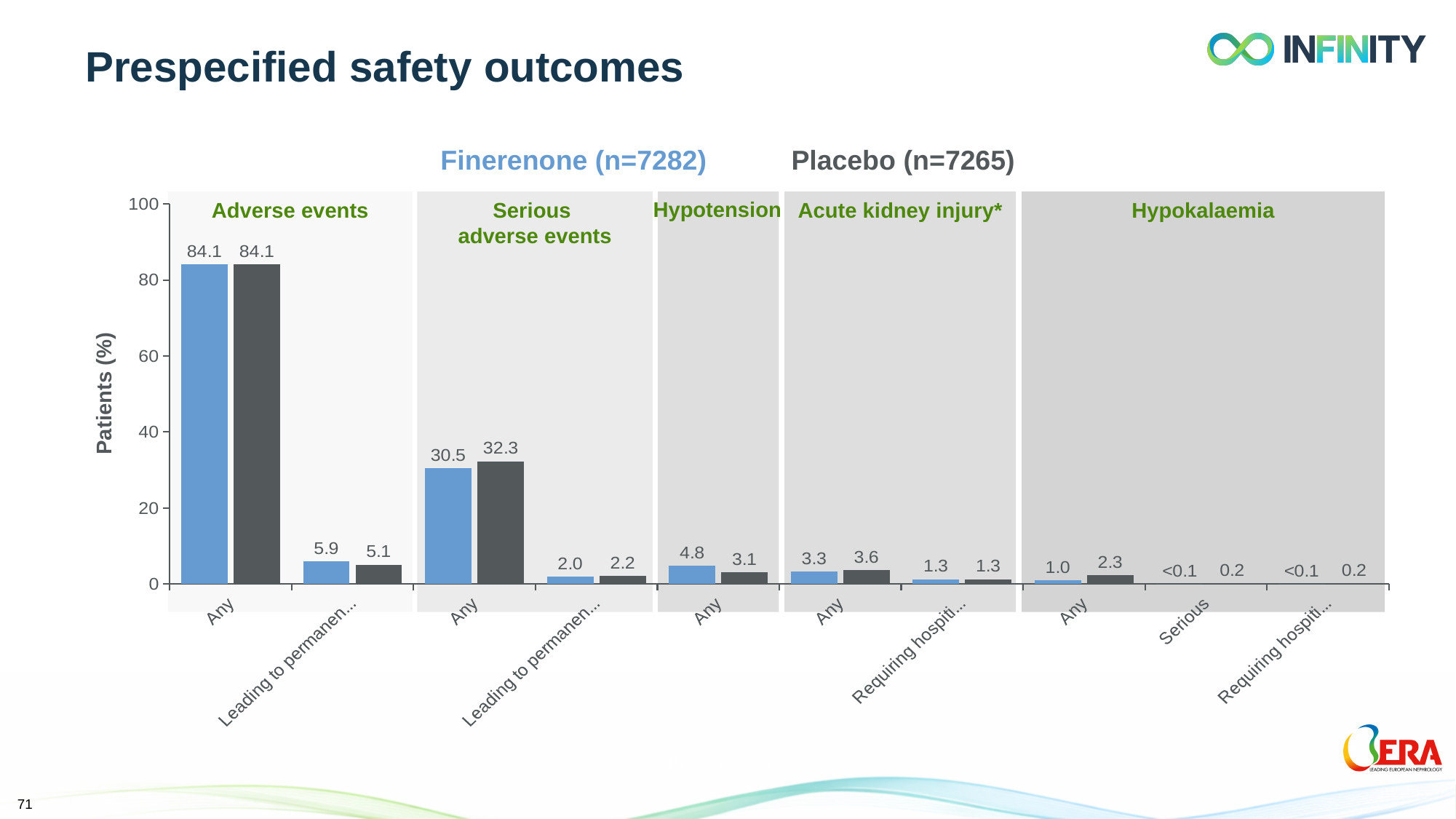
What type of chart is shown on the slide? bar chart How many series does the chart show (as named above the chart)? 2 What is the Placebo value for 'Any' in the Hypokalaemia panel? 2.3 What is the Finerenone value for 'Serious' in the Hypokalaemia panel? <0.1 Which is larger for 'Any' in the Hypotension panel, Finerenone or Placebo? Finerenone What is the Placebo value for 'Any' in the Serious adverse events panel? 32.3 What is the label of the y axis? Patients (%) Is the Finerenone value for 'Any' in the Adverse events panel greater or less than 80? greater What is the difference between the Placebo and Finerenone values for 'Any' in the Serious adverse events panel? 1.8 Which is larger for 'Any' in the Hypokalaemia panel, Finerenone or Placebo? Placebo What is the Finerenone value for 'Any' in the Adverse events panel? 84.1 What is the Finerenone value for 'Any' in the Hypotension panel? 4.8